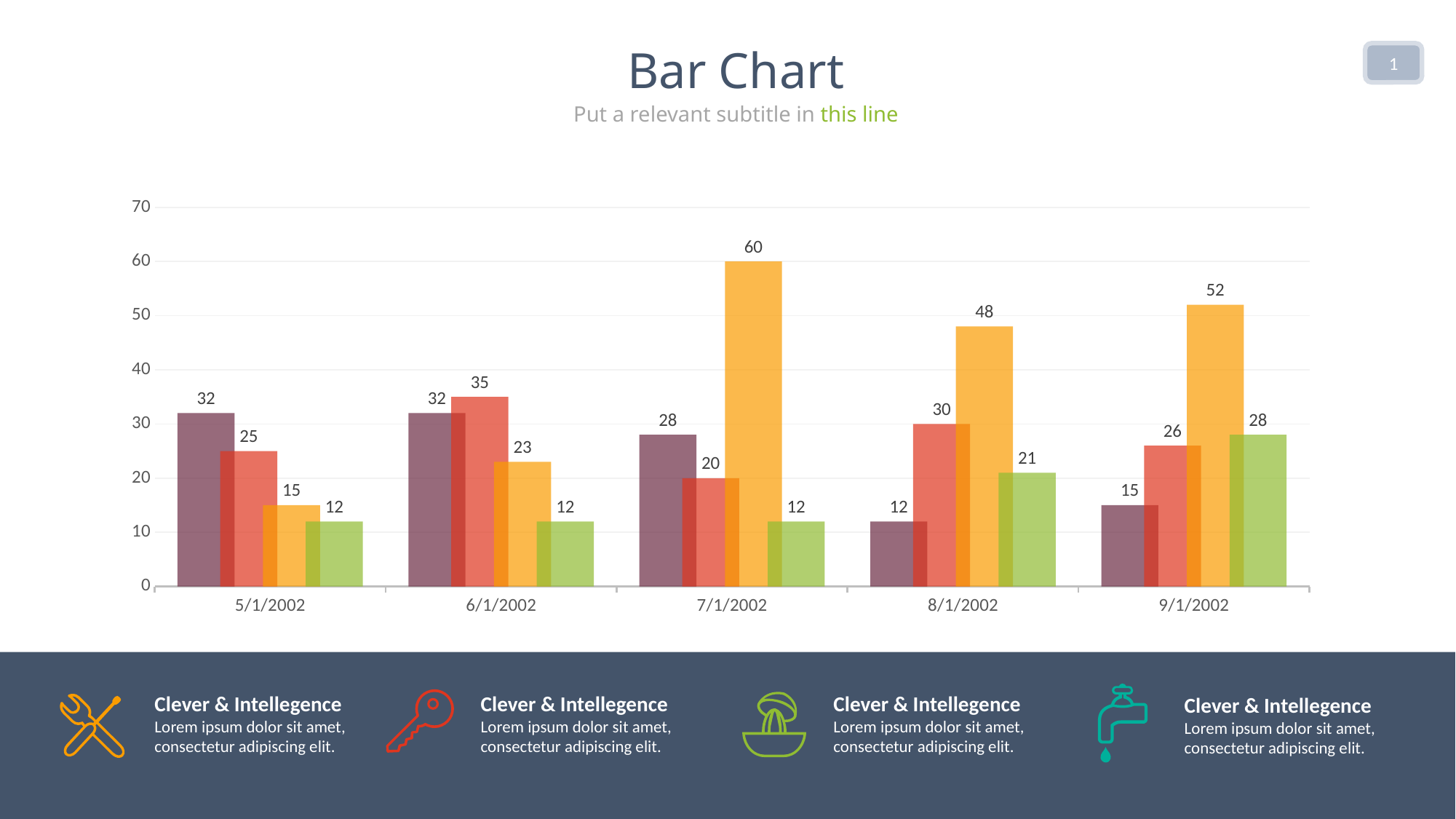
What is the value of the green bar for 9/1/2002? 28 Which is larger for 5/1/2002: the purple bar or the red bar? the purple bar What kind of chart is shown on the slide? bar chart Is the value of the orange bar for 8/1/2002 greater or less than 40? greater What is the value of the purple bar for 8/1/2002? 12 Which date has the lowest purple bar? 8/1/2002 What is the value of the red bar for 6/1/2002? 35 How many dates are shown on the x axis? 5 Which date has the highest orange bar? 7/1/2002 What is the value of the orange bar for 7/1/2002? 60 Does the green bar rise or fall from 7/1/2002 to 9/1/2002? rise What is the difference between the orange bar for 9/1/2002 and the orange bar for 8/1/2002? 4